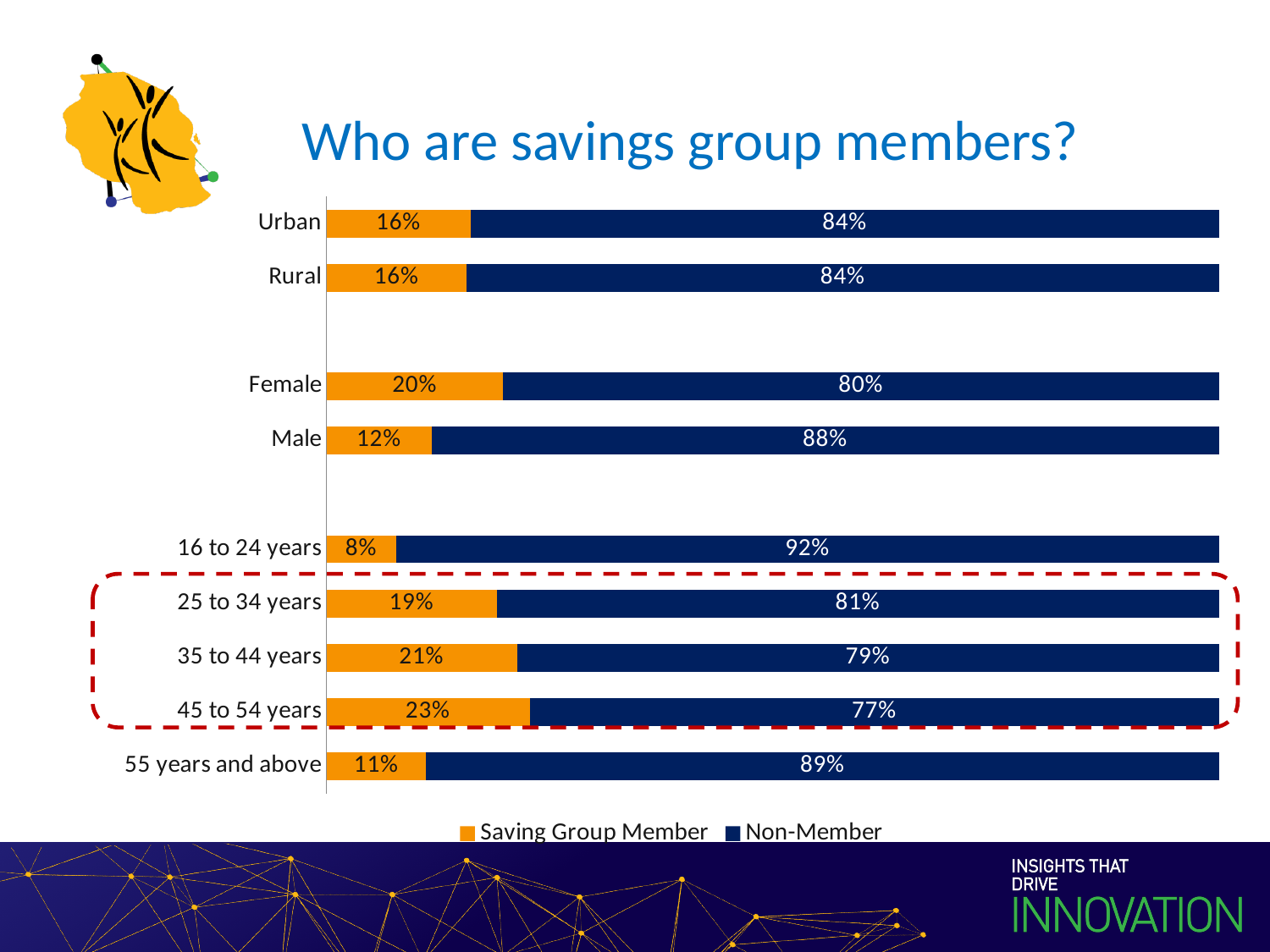
What is the Saving Group Member value for 55 years and above? 11% What is the difference between the Saving Group Member percentages for Female and Male? 8% What is the Non-Member value for the 16 to 24 years category? 92% What percentage of Female respondents are Saving Group Members? 20% What is the total of the stacked bar for Rural? 100% Which category has the highest Saving Group Member percentage? 45 to 54 years How many categories are shown on the chart? 9 What kind of chart is shown on the slide? Stacked bar chart How many series does the legend list? 2 What is the title of the chart? Who are savings group members? Which has a larger Saving Group Member share, 35 to 44 years or 25 to 34 years? 35 to 44 years Which category has the lowest Saving Group Member percentage? 16 to 24 years